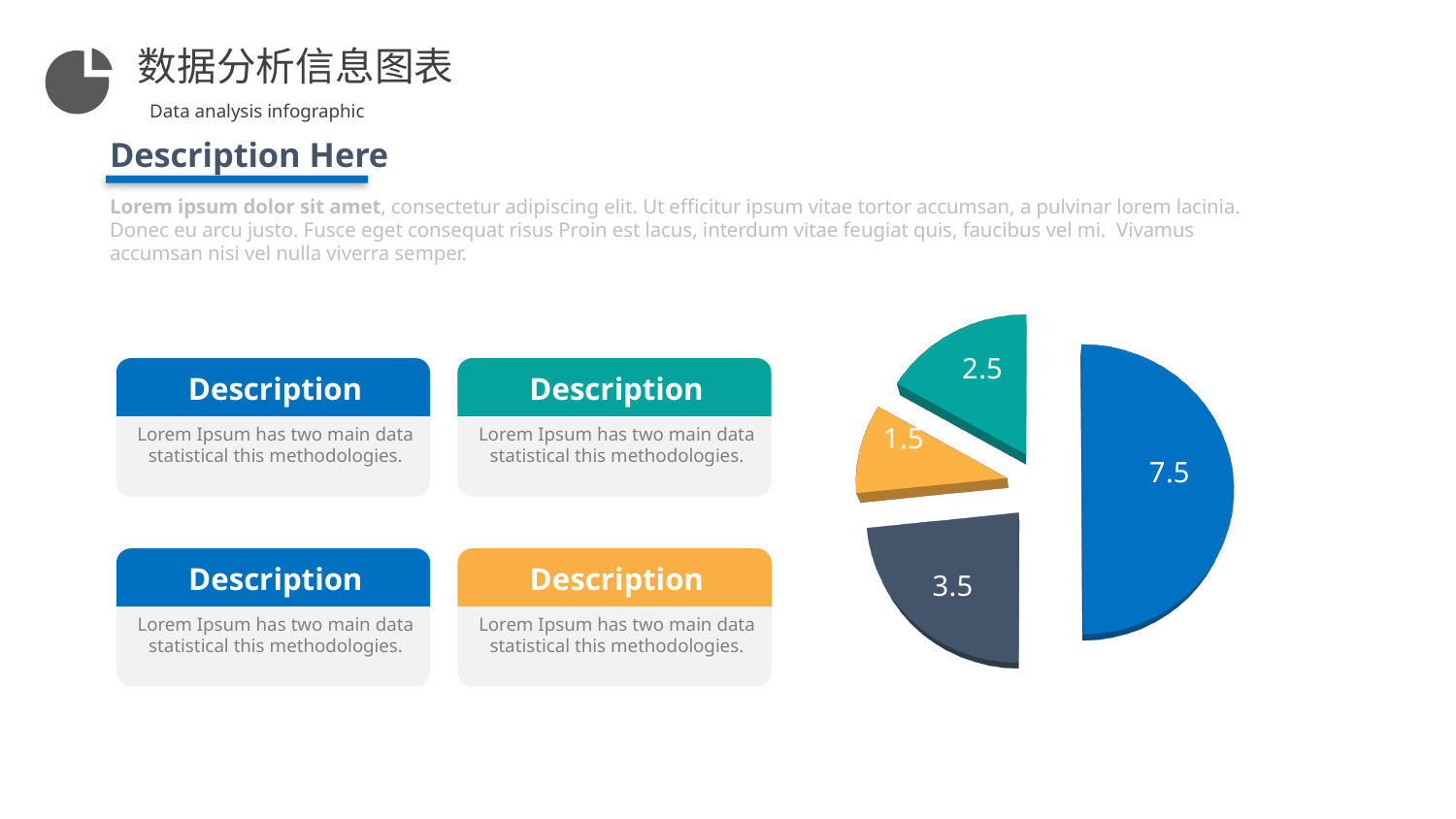
What is the difference between the blue slice and the dark grey slice in the pie chart? 4 What is the value of the orange slice in the pie chart? 1.5 How many slices does the pie chart have? 4 Which slice of the pie chart has the largest value? the blue slice (7.5) What is the total of all the slice values in the pie chart? 15 Which is larger in the pie chart, the teal slice or the orange slice? the teal slice What share of the pie chart does the blue slice represent? 50% What is the value of the blue slice in the pie chart? 7.5 What is the value of the teal slice in the pie chart? 2.5 What is the value of the dark grey slice in the pie chart? 3.5 Which slice of the pie chart has the smallest value? the orange slice (1.5) What kind of chart is shown on the slide? pie chart